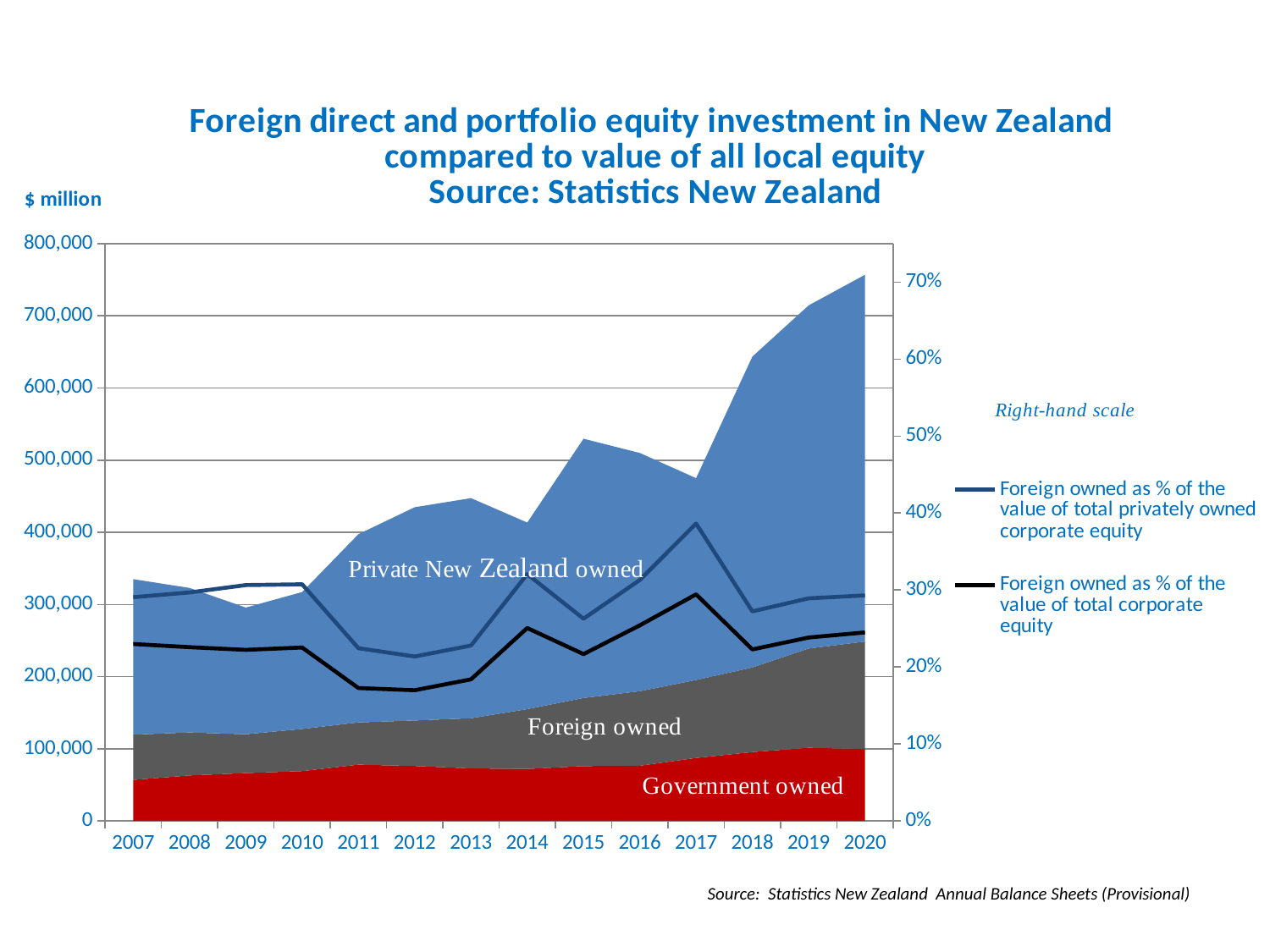
How many years are shown along the x axis of the chart? 14 Is the total value of all local equity in 2020 greater or less than 700,000? greater What is the unit label shown above the left-hand axis of the chart? $ million Is the value of 'Foreign owned as % of the value of total privately owned corporate equity' in 2017 greater or less than 30%? greater How many series does the legend on the right of the chart list? 2 Which year has the higher value for 'Foreign owned as % of the value of total corporate equity', 2017 or 2018? 2017 What kind of chart is shown on the slide? Stacked area chart with line series Does the total value of all local equity generally rise or fall from 2007 to 2020? rise Is the value of 'Foreign owned as % of the value of total corporate equity' in 2011 greater or less than 20%? less Which year has the highest total value of all local equity (top of the stacked areas)? 2020